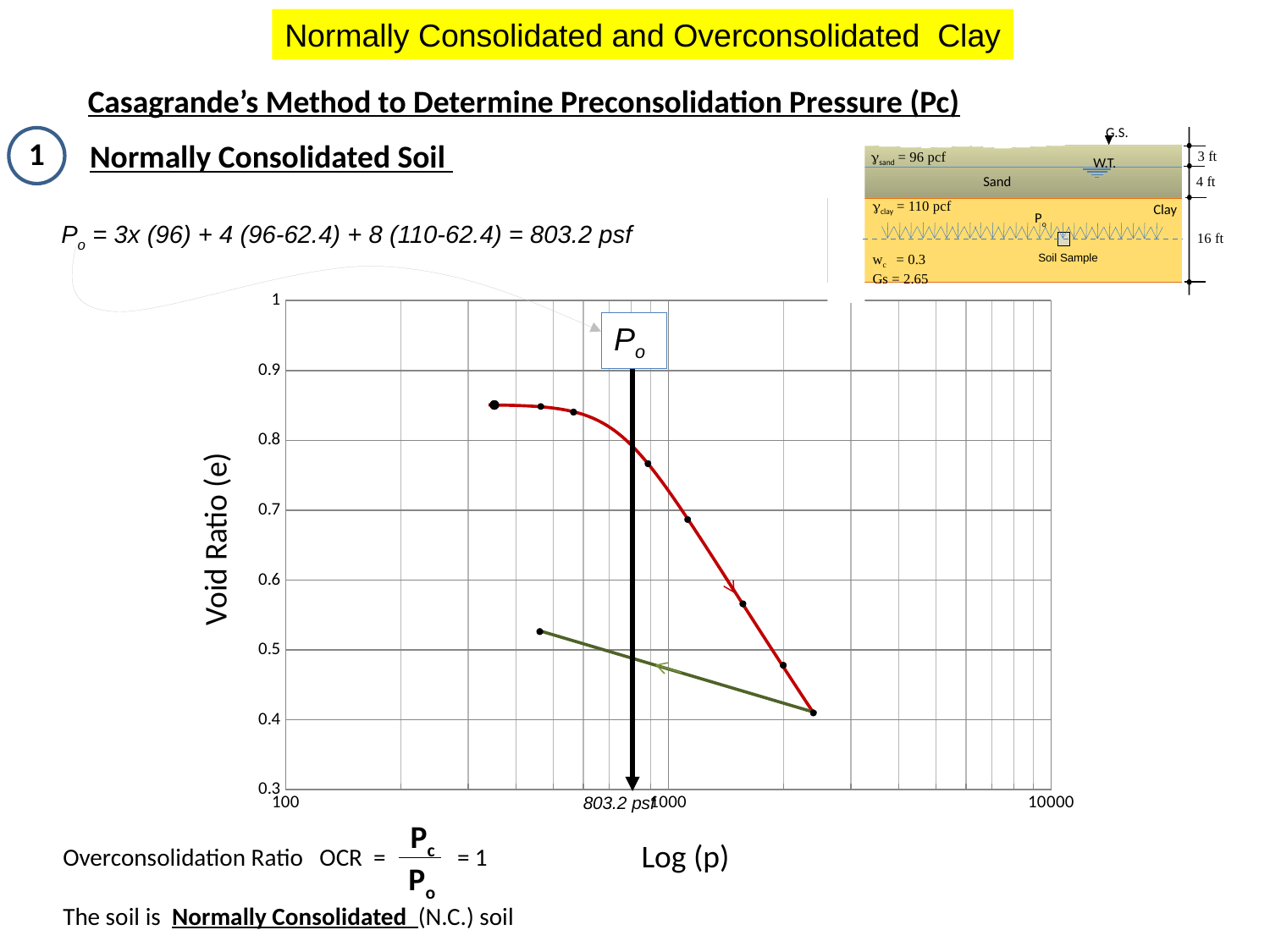
What pressure value is marked by the vertical Po arrow on the chart? 803.2 psf What is the highest value shown on the horizontal axis of the chart? 10000 What is the label of the horizontal axis of the chart? Log (p) What kind of chart is shown on the slide? line chart Which point on the red curve has the lower void ratio, the leftmost point or the rightmost point? the rightmost point Is the void ratio of the leftmost point on the red curve greater or less than 0.8? greater Along the red curve, does the void ratio rise or fall as the pressure increases? fall Is the void ratio of the left end of the green line greater or less than 0.6? less How many data points are marked on the green line? 2 What is the lowest value shown on the vertical axis of the chart? 0.3 What is the label of the vertical axis of the chart? Void Ratio (e) Is the void ratio of the lowest point on the red curve greater or less than 0.5? less